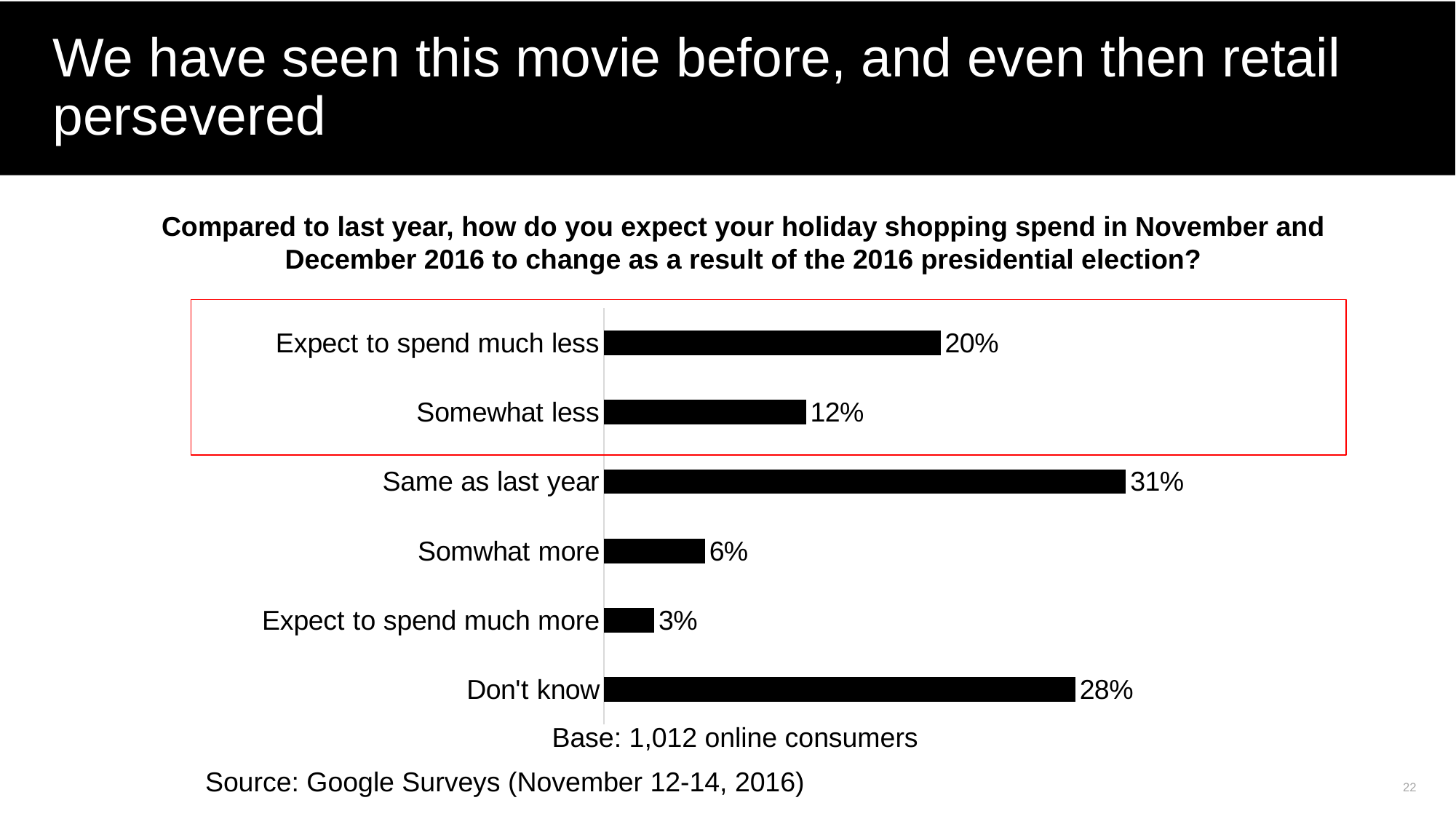
What percentage of respondents expect to spend much less? 20% What is the value for 'Somewhat less'? 12% Which category has the lowest value? Expect to spend much more Which is larger, 'Somwhat more' or 'Somewhat less'? Somewhat less What is the difference between 'Same as last year' and 'Don't know'? 3% What kind of chart is shown on the slide? Bar chart What is the value for 'Expect to spend much more'? 3% How many categories are shown in the chart? 6 What is the combined value of 'Expect to spend much less' and 'Somewhat less'? 32% What is the base (number of respondents) stated below the chart? 1,012 online consumers Which category has the highest value? Same as last year What is the value for 'Don't know'? 28%